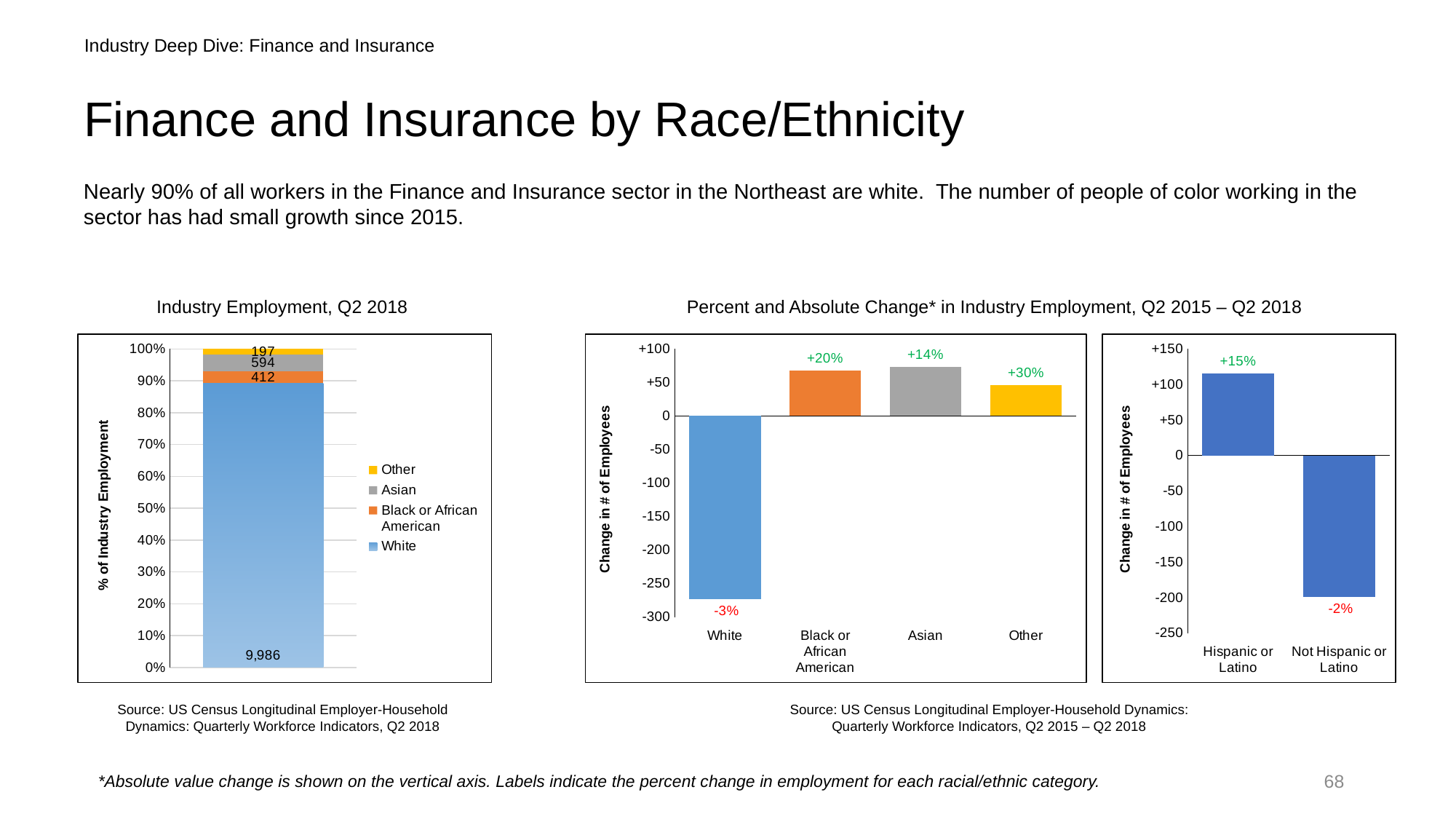
In the 'Industry Employment, Q2 2018' chart, what is the difference between the Asian and Black or African American values? 182 In the 'Percent and Absolute Change in Industry Employment' chart (middle), how many racial/ethnic categories are plotted? 4 In the 'Percent and Absolute Change in Industry Employment' chart (middle), is the change in number of employees for White greater or less than -250? less In the rightmost chart, is the change in number of employees for Not Hispanic or Latino greater or less than -150? less In the 'Industry Employment, Q2 2018' chart, what is the total of all segments in the stacked bar? 11,189 In the 'Industry Employment, Q2 2018' chart, which group has the smallest segment? Other In the 'Industry Employment, Q2 2018' chart, what is the value shown for White? 9,986 In the 'Percent and Absolute Change in Industry Employment' chart (middle), what percent change label is shown for White? -3% In the 'Percent and Absolute Change in Industry Employment' chart (middle), what percent change label is shown for Other? +30% In the 'Industry Employment, Q2 2018' chart, what is the value shown for Asian? 594 In the 'Industry Employment, Q2 2018' chart, how many series does the legend list? 4 In the rightmost chart, what percent change label is shown for Hispanic or Latino? +15%